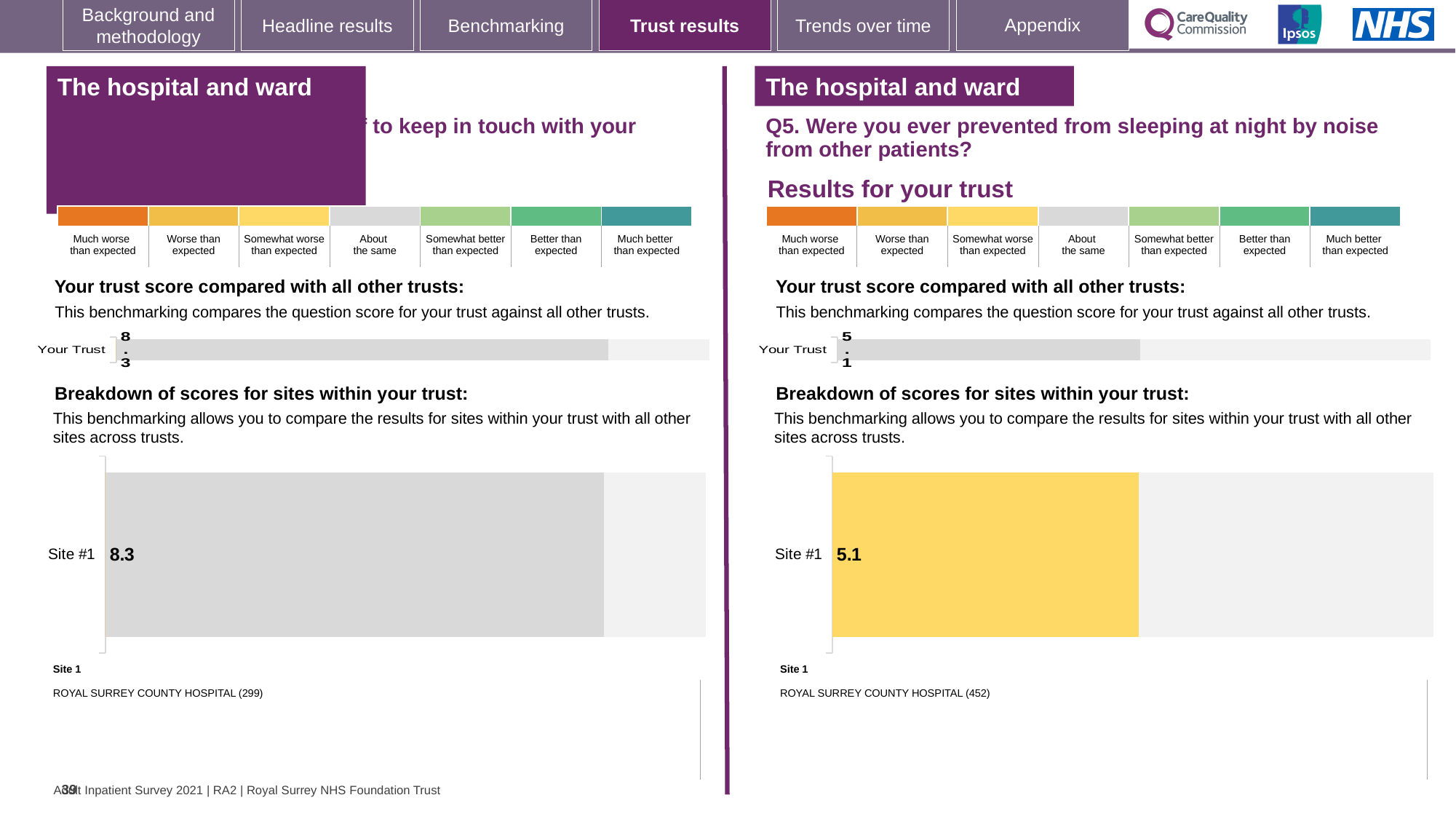
Which site name is listed as Site 1 on the right-hand side of the slide? ROYAL SURREY COUNTY HOSPITAL (452) How many sites are shown in the right-hand 'Breakdown of scores for sites within your trust' chart? 1 What type of chart is used to show the Site #1 score on the right-hand side of the slide? Bar chart In the left-hand 'Breakdown of scores for sites within your trust' chart, what is the score for Site #1? 8.3 On the right-hand side of the slide (Q5), what is the score shown for Your Trust? 5.1 What is the difference between the Site #1 score on the left-hand chart and the Site #1 score on the right-hand chart? 3.2 Which is larger: the Site #1 score in the left-hand breakdown chart or the Site #1 score in the right-hand breakdown chart? Left-hand (8.3) What colour is the Site #1 bar in the right-hand breakdown chart? Yellow On the left-hand side of the slide, what is the score shown for Your Trust? 8.3 In the right-hand 'Breakdown of scores for sites within your trust' chart, what is the score for Site #1? 5.1 How many sites are shown in the left-hand 'Breakdown of scores for sites within your trust' chart? 1